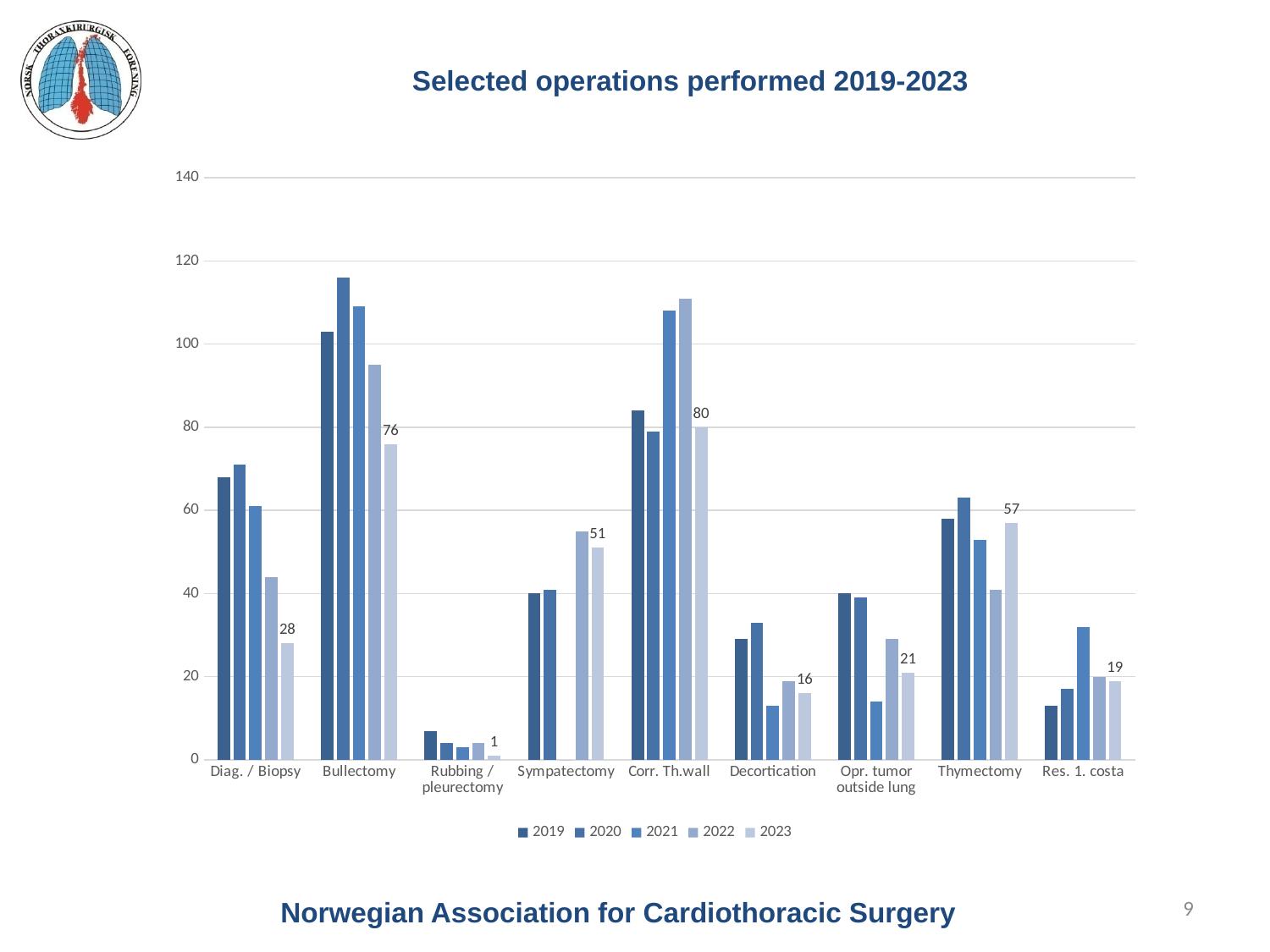
What is the value for Corr. Th.wall in 2023? 80 Which is larger in 2023: Bullectomy or Thymectomy? Bullectomy Among the 2023 values, which operation has the lowest value? Rubbing / pleurectomy What is the value for Bullectomy in 2023? 76 What is the difference between the 2023 values for Corr. Th.wall and Bullectomy? 4 Is the value for Bullectomy in 2020 greater or less than 100? greater How many operation categories are shown on the x axis? 9 What kind of chart is shown on the slide? Bar chart Among the 2023 values, which operation has the highest value? Corr. Th.wall How many series does the legend list? 5 What is the value for Thymectomy in 2023? 57 What is the value for Rubbing / pleurectomy in 2023? 1